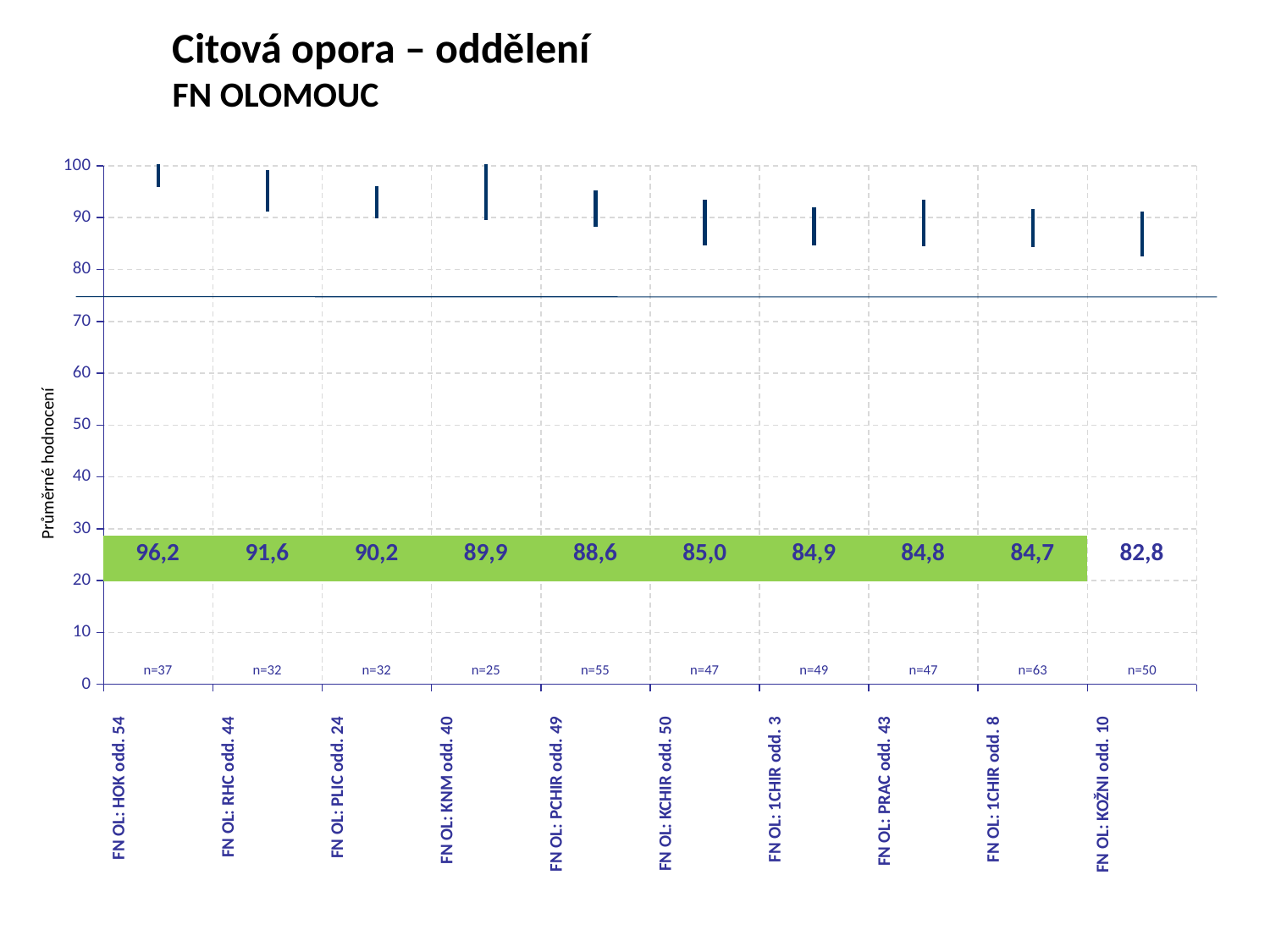
What is the label of the vertical axis? Průměrné hodnocení Which department has the lowest average rating? FN OL: KOŽNI odd. 10 What is the difference between the average ratings of FN OL: RHC odd. 44 and FN OL: PLIC odd. 24? 1,4 Which department has the highest average rating? FN OL: HOK odd. 54 What is the average rating shown for FN OL: KNM odd. 40? 89,9 Is the average rating for FN OL: PRAC odd. 43 greater or less than 80? greater What is the difference between the average rating of FN OL: HOK odd. 54 and FN OL: KOŽNI odd. 10? 13,4 What is the sample size (n) shown for FN OL: 1CHIR odd. 8? n=63 Which has a higher average rating, FN OL: PCHIR odd. 49 or FN OL: KCHIR odd. 50? FN OL: PCHIR odd. 49 How many departments are shown on the chart? 10 What is the average rating (průměrné hodnocení) for FN OL: HOK odd. 54? 96,2 Do the average ratings rise or fall from left to right along the x axis? fall